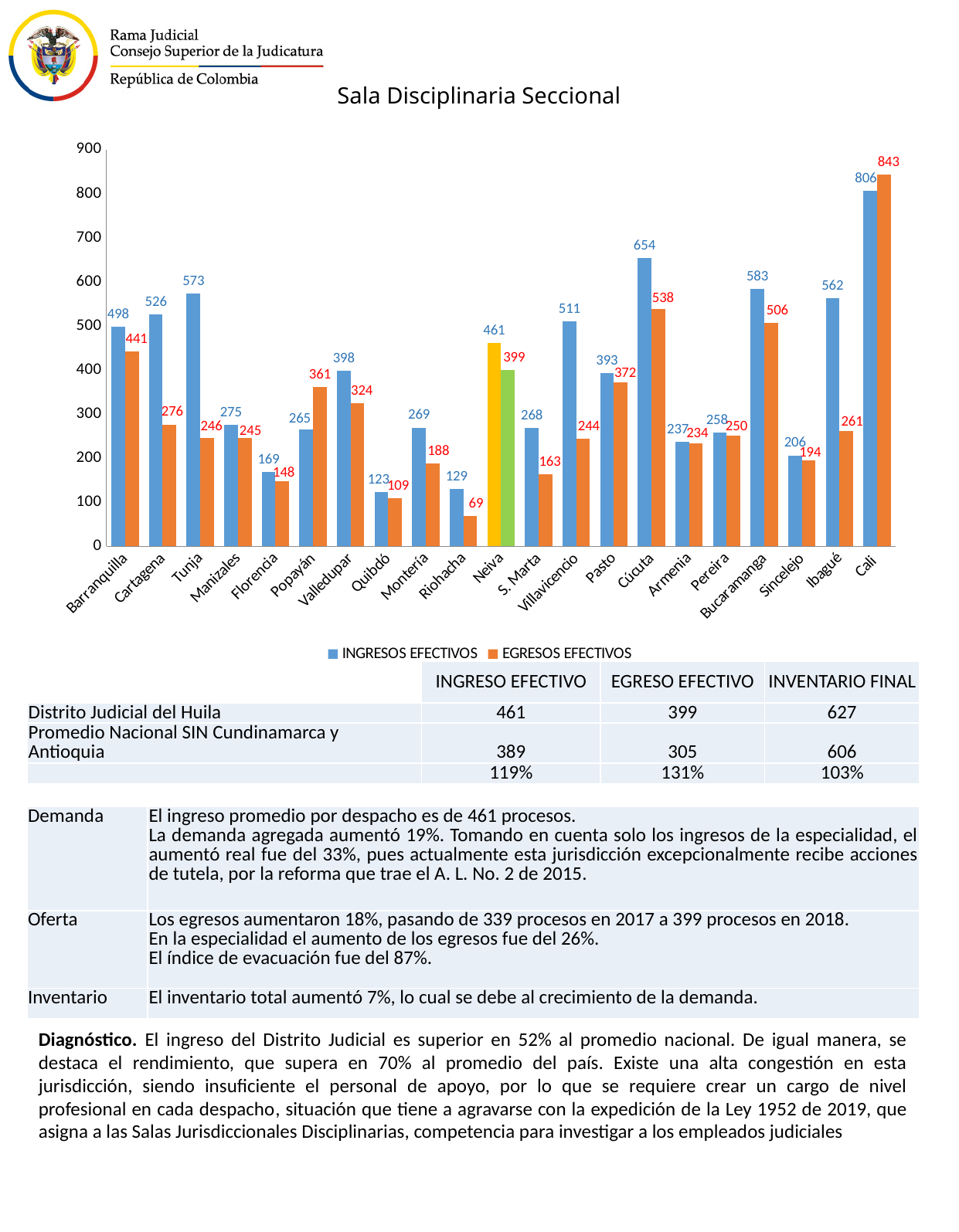
Which city has the lowest EGRESOS EFECTIVOS value? Riohacha What kind of chart is shown on the slide? bar chart Is the INGRESOS EFECTIVOS value for Bucaramanga greater or less than 500? greater What is the title of the chart? Sala Disciplinaria Seccional For Popayán, which is larger: INGRESOS EFECTIVOS or EGRESOS EFECTIVOS? EGRESOS EFECTIVOS What is the INGRESOS EFECTIVOS value for Neiva? 461 What is the INGRESOS EFECTIVOS value for Tunja? 573 How many series does the chart legend list? 2 What is the EGRESOS EFECTIVOS value for Cúcuta? 538 How many cities are shown on the x axis of the chart? 21 Which city has the highest INGRESOS EFECTIVOS value? Cali What is the difference between the EGRESOS EFECTIVOS and INGRESOS EFECTIVOS values for Cali? 37